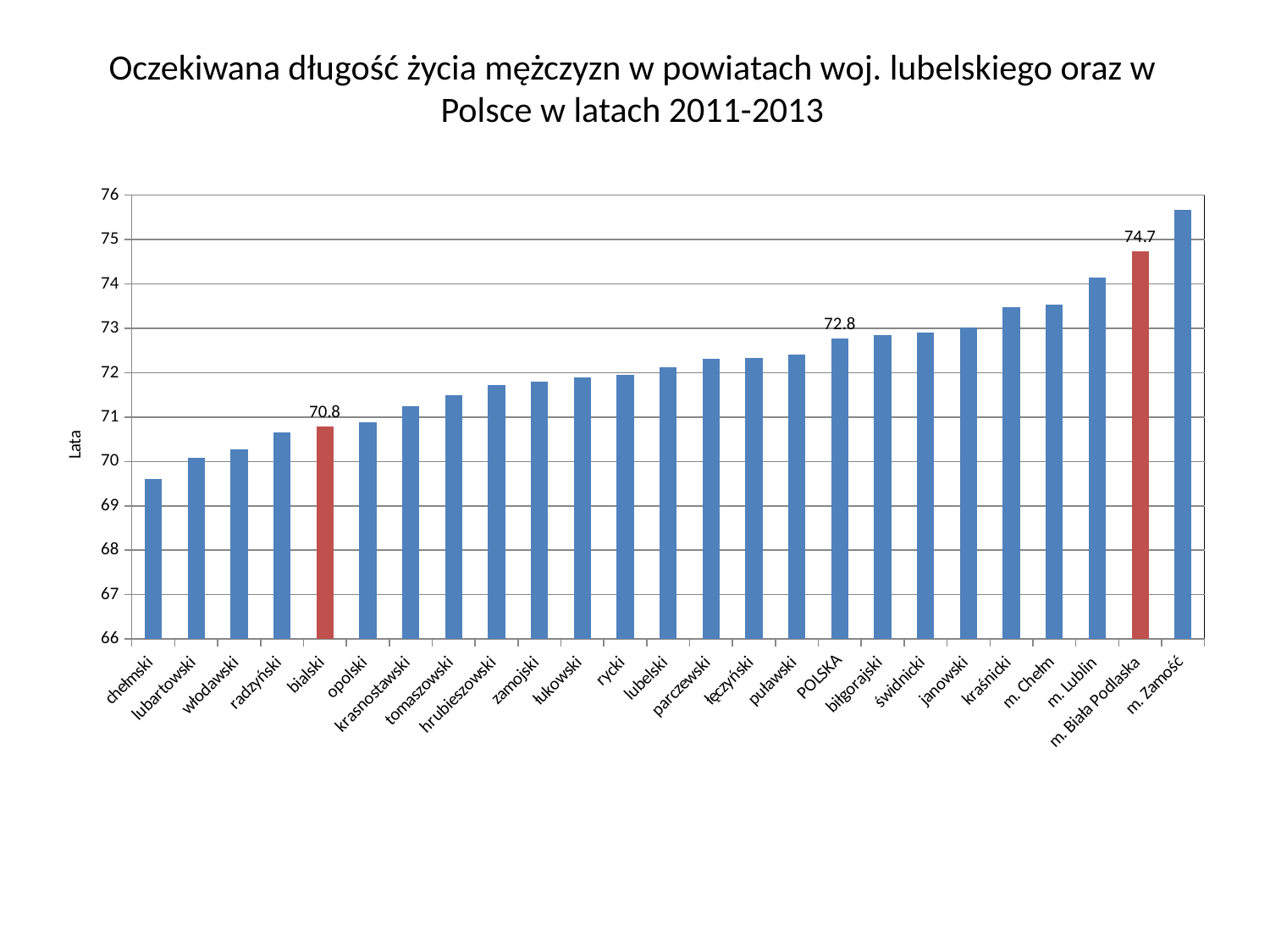
What is the expected life expectancy value shown for bialski? 70.8 Which category has the highest bar? m. Zamość How many categories are shown on the x axis? 25 Do the values rise or fall from left to right along the x axis? rise Which is larger, the value for m. Lublin or the value for m. Chełm? m. Lublin Is the value for m. Zamość greater or less than 75? greater What value is labelled for m. Biała Podlaska? 74.7 Is the value for chełmski greater or less than 70? less What is the difference between the values for POLSKA and bialski? 2.0 Which category has the lowest bar? chełmski What is the difference between the values for m. Biała Podlaska and bialski? 3.9 What value is labelled for POLSKA? 72.8